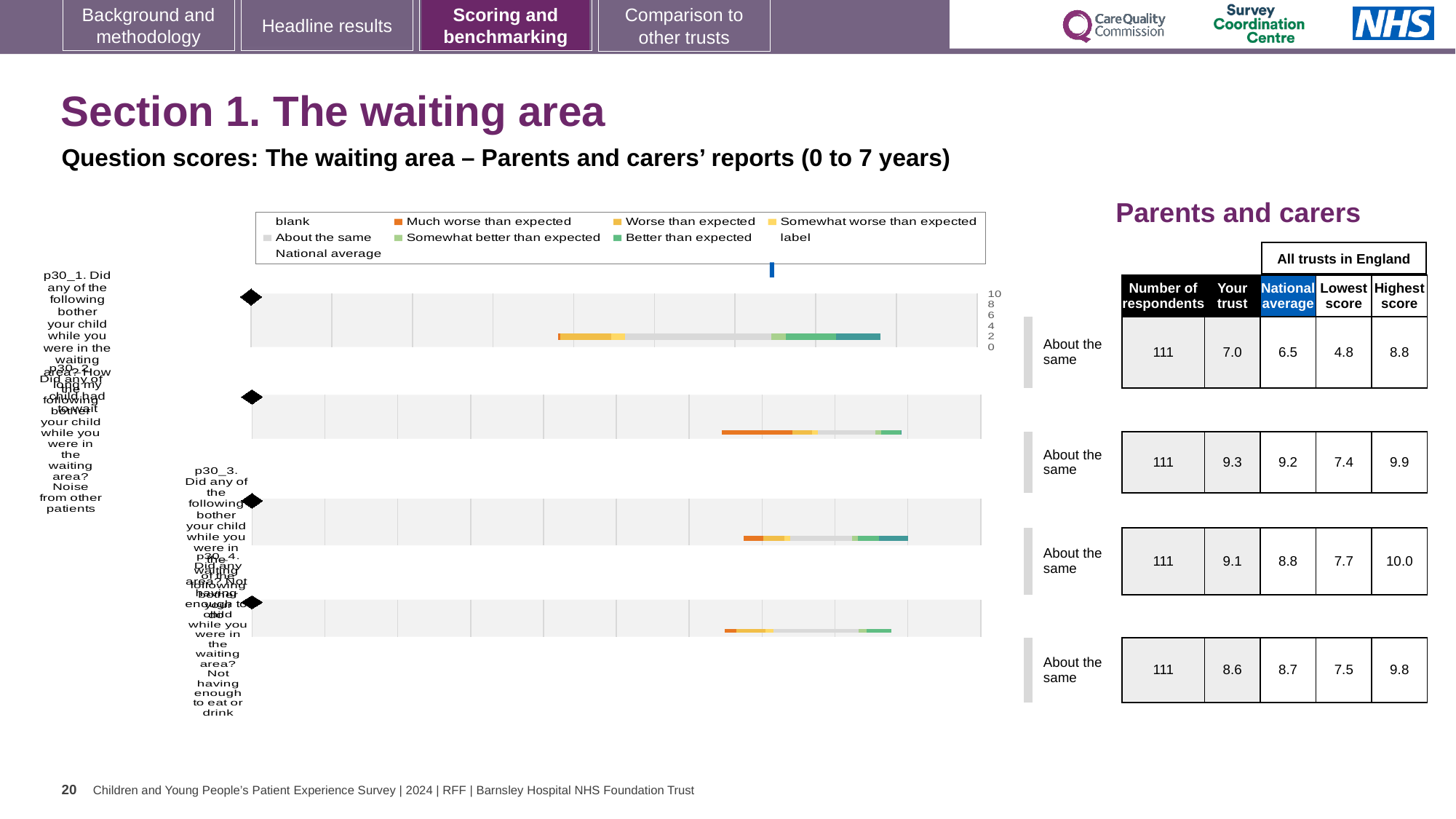
In the table, what is the highest score in the third row? 10.0 In the table, what is the lowest score in the fourth row? 7.5 Which row of the table has the lowest 'Your trust' score? first row (7.0) What benchmark category is shown next to each of the four rows? About the same In the first row of the table, what is the difference between the 'Your trust' score and the national average? 0.5 What kind of chart is shown on the left of the slide? bar chart Which row of the table has the highest 'Your trust' score? second row (9.3) In the table, what is the 'Your trust' score in the first row? 7.0 In the table, what is the number of respondents for the first row? 111 In the fourth row of the table, which is larger: the 'Your trust' score or the national average? national average (8.7) How many question bars are plotted in the chart? 4 In the table, what is the national average in the second row? 9.2